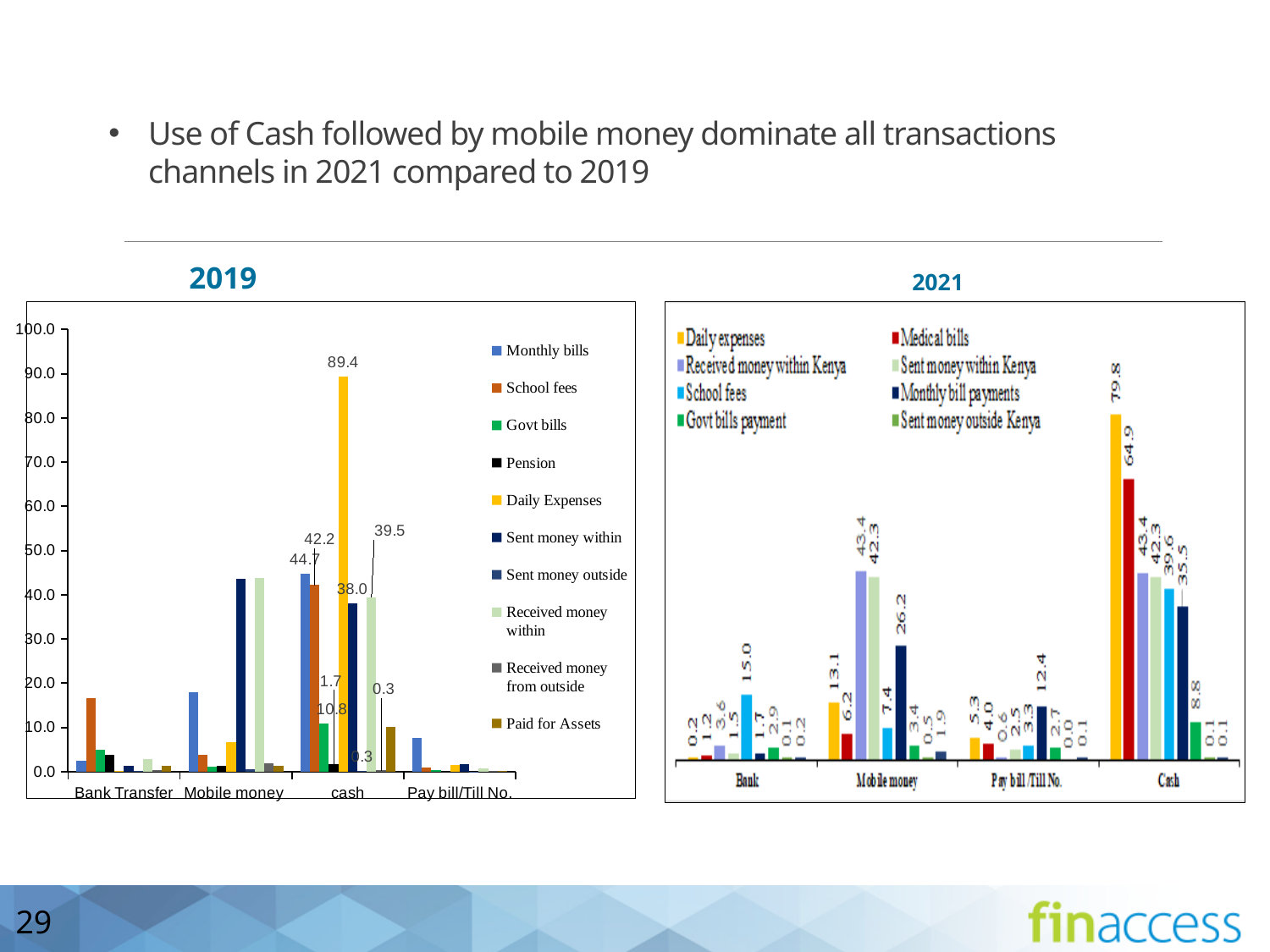
In the 2021 chart, what is the value of School fees for Bank? 15.0 In the 2021 chart, what is the value of Monthly bill payments for Mobile money? 26.2 In the 2019 chart, how many transaction channel categories are shown on the x axis? 4 What kind of chart is the 2019 chart? Bar chart In the 2019 chart, which series has the highest value in the cash group? Daily Expenses In the 2021 chart, which category has the highest Daily expenses value? Cash In the 2019 chart, what is the value of Daily Expenses for cash? 89.4 In the 2021 chart, what is the value of Daily expenses for Cash? 79.8 In the 2019 chart, what is the value of Sent money within for cash? 38.0 In the 2021 chart, is Monthly bill payments larger for Mobile money or for Pay bill/Till No.? Mobile money In the 2021 chart, what is the difference between Daily expenses and Medical bills for Cash? 14.9 In the 2019 chart, how many series does the legend list? 10